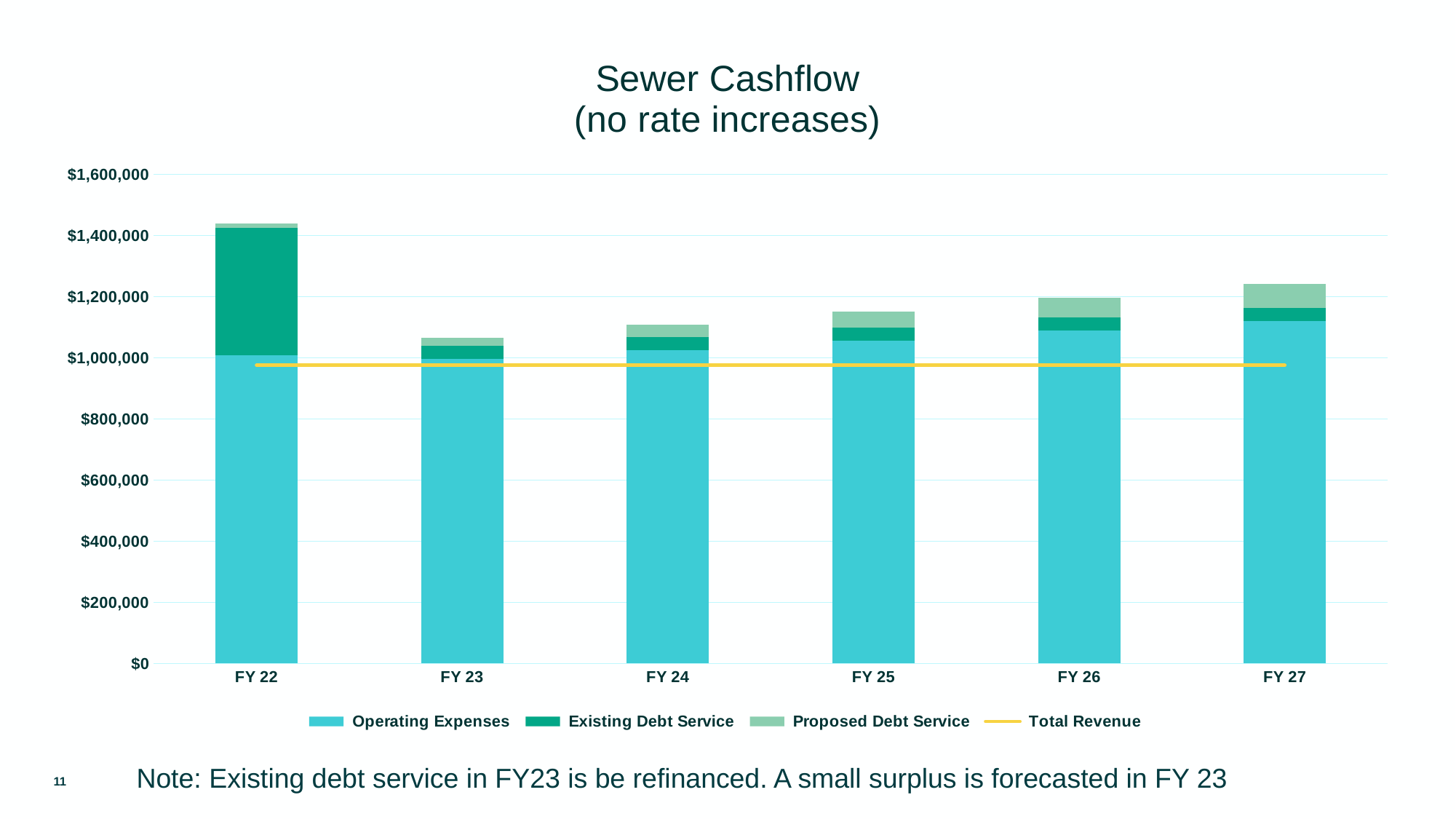
How many fiscal years are shown on the x axis? 6 Is the total stacked bar for FY 25 greater or less than $1,200,000? less Do the Operating Expenses values rise or fall from FY 23 to FY 27? rise Is the total stacked bar for FY 27 greater or less than $1,200,000? greater Which fiscal year has the shortest stacked bar? FY 23 Which fiscal year has the tallest stacked bar? FY 22 Is the Total Revenue line greater or less than $1,000,000? less What kind of chart is shown on the slide? Stacked bar chart with a line Which has the larger total stacked bar, FY 24 or FY 27? FY 27 How many series does the legend list? 4 Which series is plotted as a line rather than as bars? Total Revenue